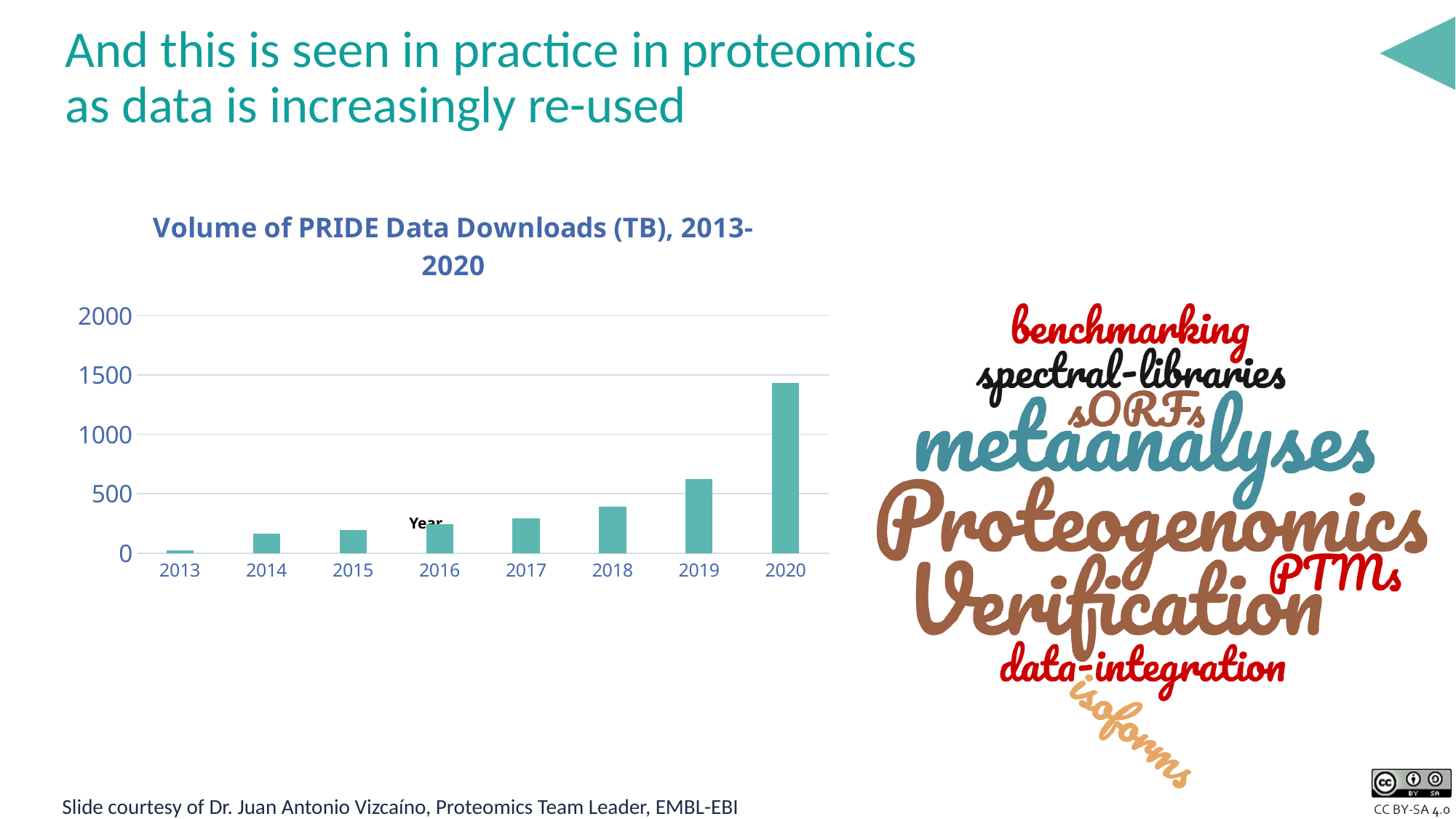
Which is larger, the value for 2019 or the value for 2018? 2019 How many years are plotted on the chart? 8 What kind of chart is shown on the slide? bar chart Which year has the highest volume of PRIDE data downloads? 2020 Is the value for 2020 greater or less than 1000? greater What is the label on the x axis of the chart? Year What is the title of the chart? Volume of PRIDE Data Downloads (TB), 2013-2020 Is the value for 2018 greater or less than 500? less Is the value for 2020 greater or less than 1500? less Which year has the lowest volume of PRIDE data downloads? 2013 Do the values rise or fall from 2013 to 2020? rise